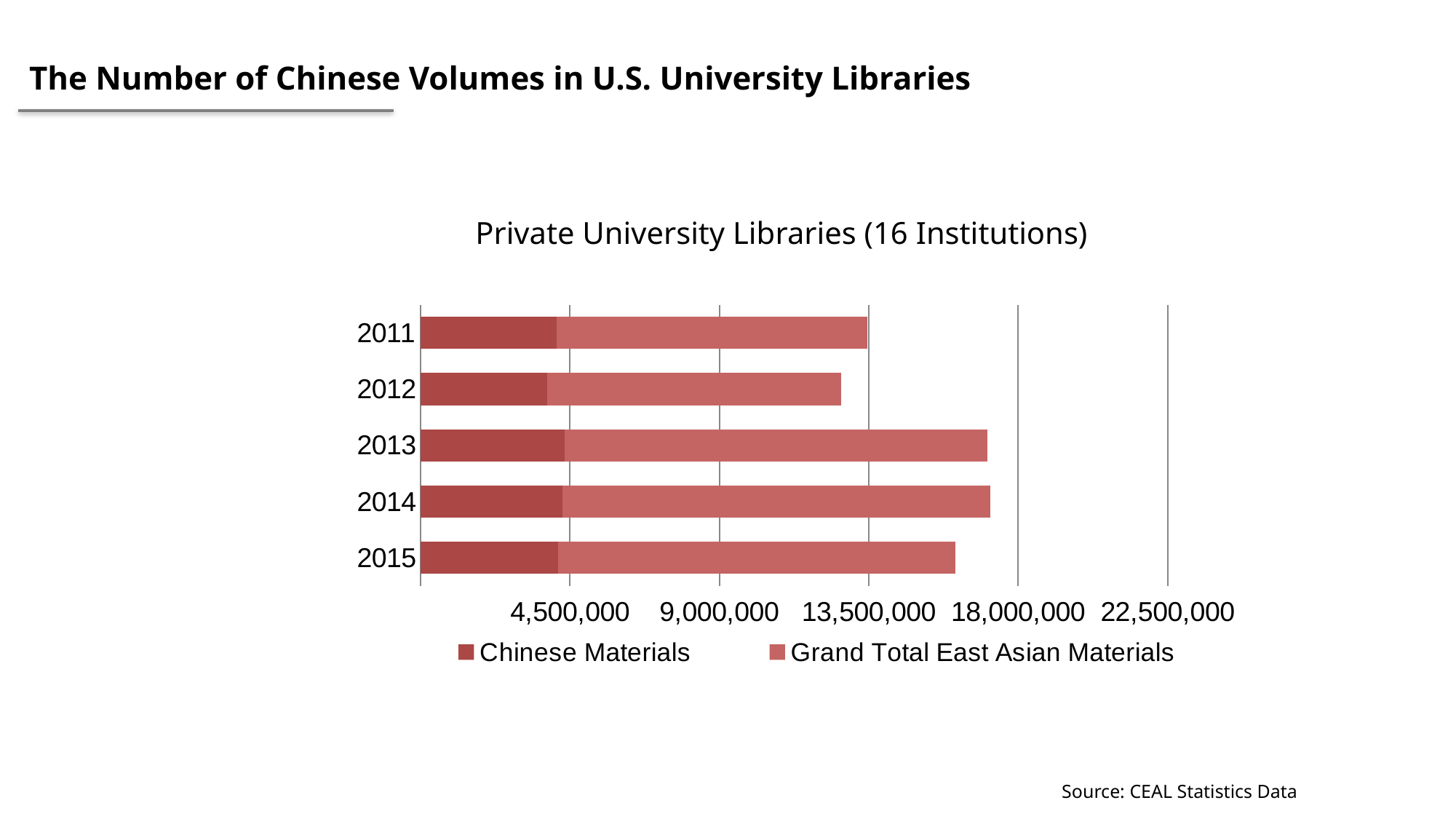
Which year has the shortest total bar? 2012 What kind of chart is shown on the slide? bar chart Is the total bar for 2012 longer or shorter than the total bar for 2013? shorter What is the title of the chart? Private University Libraries (16 Institutions) How many series does the legend list? 2 Is the Chinese Materials value for 2012 greater or less than 4,500,000? less Is the total bar for 2012 greater or less than 13,500,000? less Which series is shown in the darker red colour in the legend? Chinese Materials How many years are shown on the chart? 5 Is the total bar for 2015 greater or less than 13,500,000? greater Is the total bar for 2015 longer or shorter than the total bar for 2012? longer